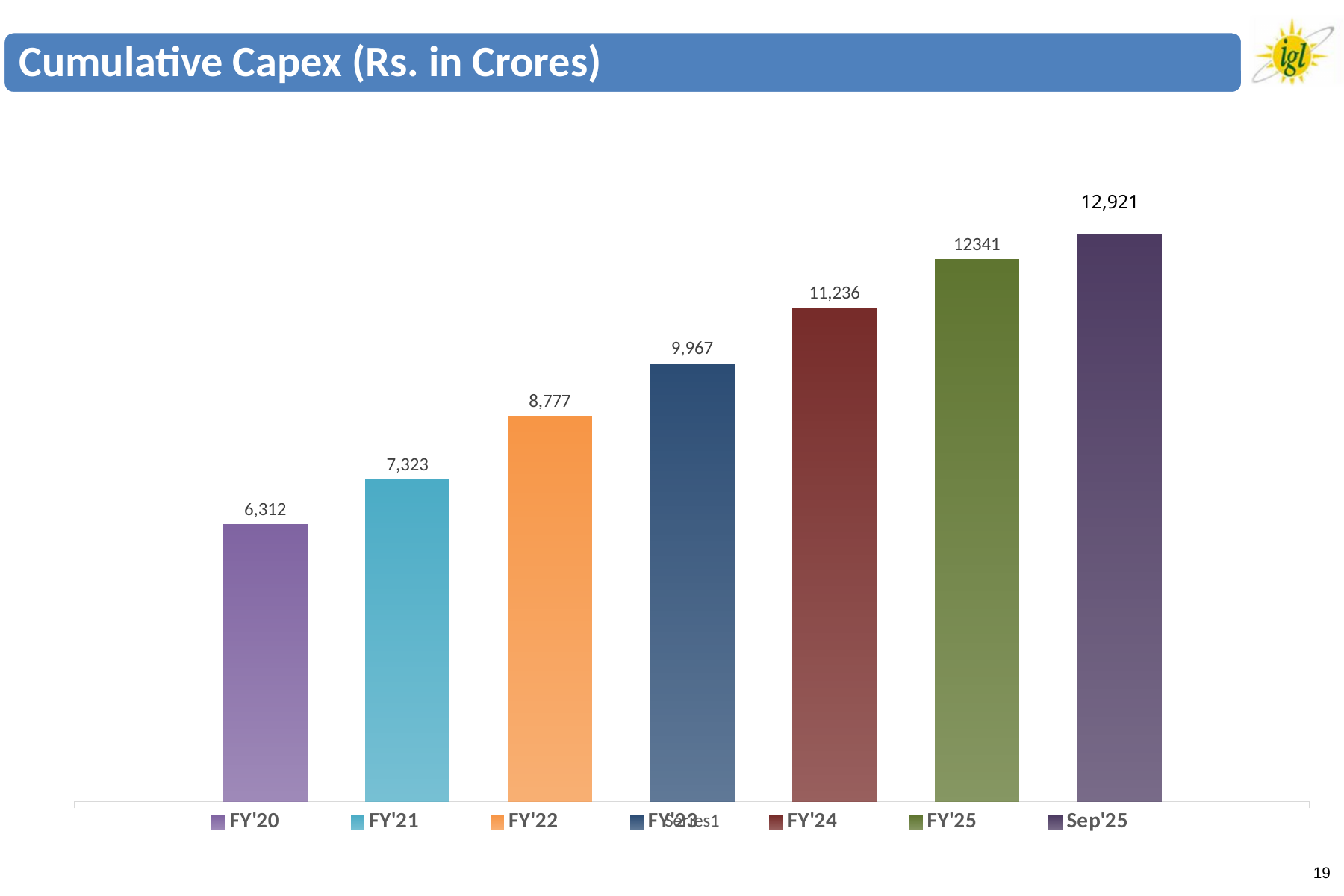
Which period has the lowest cumulative capex? FY'20 What is the cumulative capex value shown for FY'23? 9,967 What is the cumulative capex value shown for FY'20? 6,312 What is the difference between the cumulative capex for FY'24 and FY'23? 1,269 How many bars are plotted in the chart? 7 Do the cumulative capex values rise or fall from FY'20 to Sep'25? Rise Which period has the highest cumulative capex? Sep'25 Which is larger, the cumulative capex for FY'22 or FY'21? FY'22 What kind of chart is shown on the slide? Bar chart What is the difference between the cumulative capex for Sep'25 and FY'25? 580 What is the cumulative capex value shown for Sep'25? 12,921 What is the cumulative capex value shown for FY'25? 12341